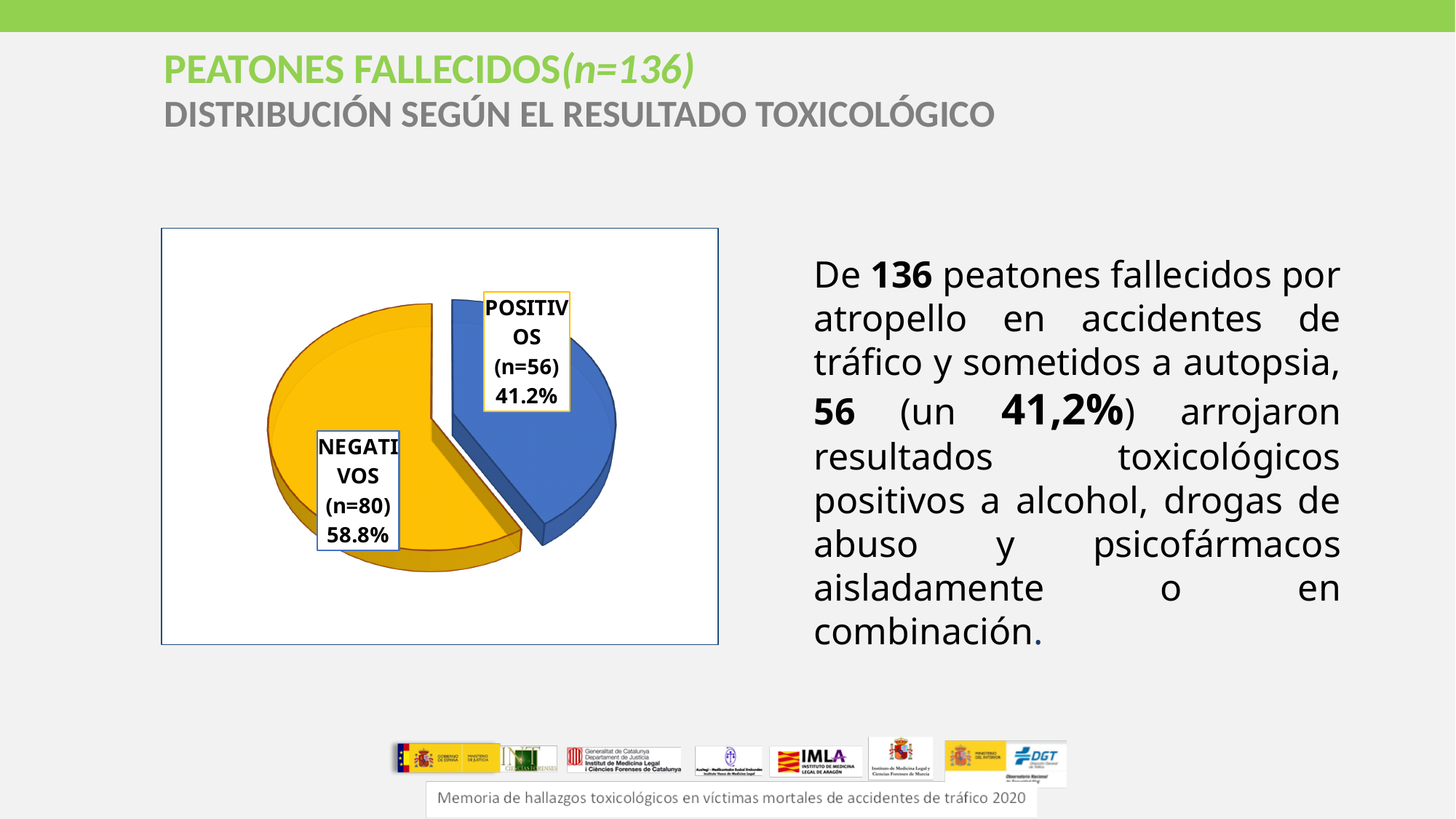
What is the count (n) for the POSITIVOS slice? n=56 What colour is the NEGATIVOS slice of the pie chart? yellow What colour is the POSITIVOS slice of the pie chart? blue What percentage share does the NEGATIVOS slice represent? 58.8% What kind of chart is shown on the slide? pie chart What is the count (n) for the NEGATIVOS slice? n=80 How many slices does the pie chart have? 2 What is the total number of cases represented by the two slices of the pie chart? 136 What percentage share does the POSITIVOS slice represent? 41.2% Which category has the smallest slice in the pie chart? POSITIVOS What is the difference in count between the NEGATIVOS and POSITIVOS slices? 24 Which slice is larger, POSITIVOS or NEGATIVOS? NEGATIVOS